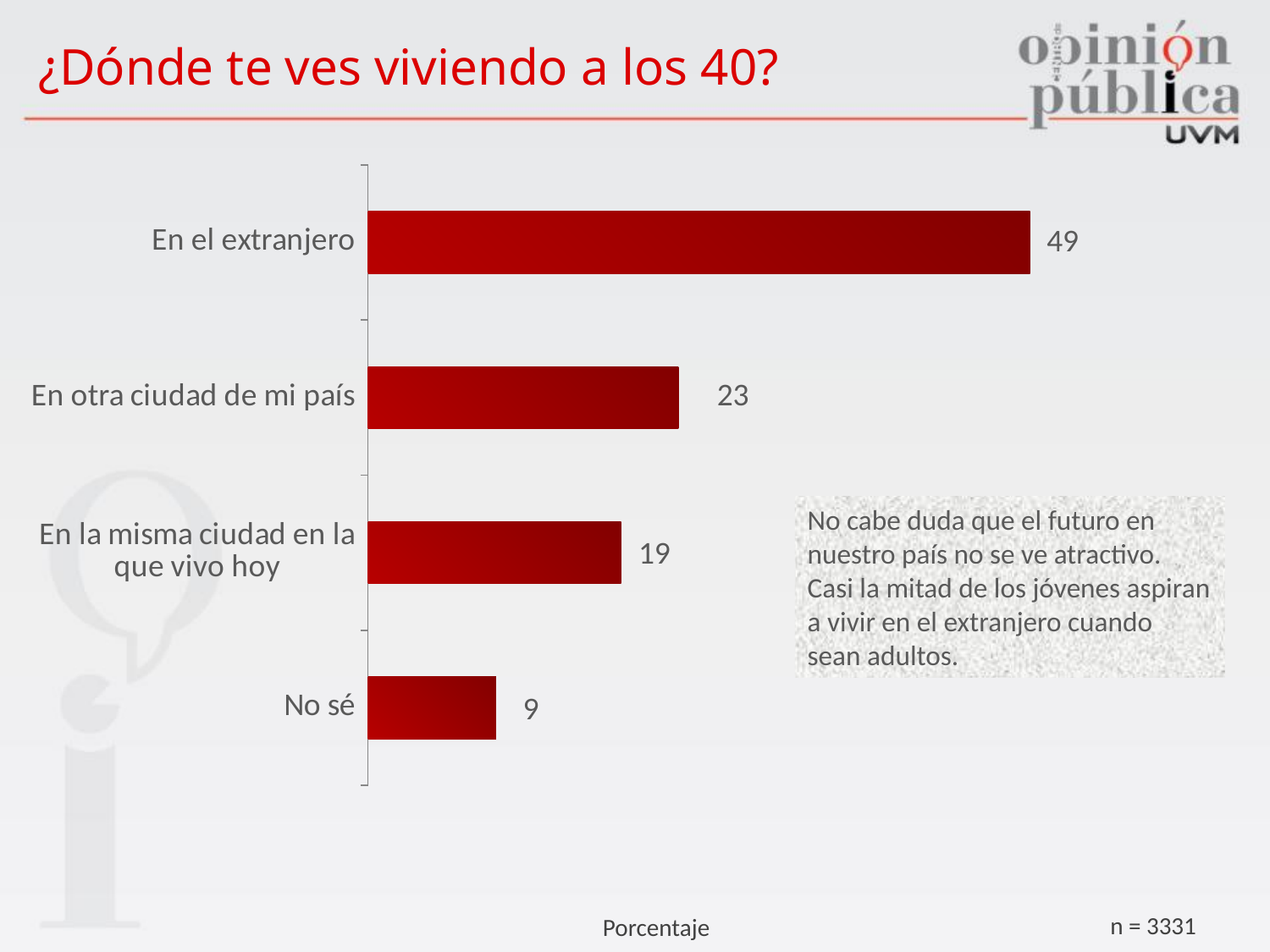
What is the value for "En otra ciudad de mi país"? 23 What is the value for "No sé"? 9 Which category has the highest value? En el extranjero What is the difference between the values for "En el extranjero" and "En otra ciudad de mi país"? 26 Which category has the lowest value? No sé What is the difference between the values for "En la misma ciudad en la que vivo hoy" and "No sé"? 10 What is the value for "En la misma ciudad en la que vivo hoy"? 19 How many categories are shown in the chart? 4 What is the label shown below the chart for the measured quantity? Porcentaje What is the value for "En el extranjero"? 49 Which is larger, the value for "En otra ciudad de mi país" or for "En la misma ciudad en la que vivo hoy"? En otra ciudad de mi país What kind of chart is shown on the slide? Bar chart